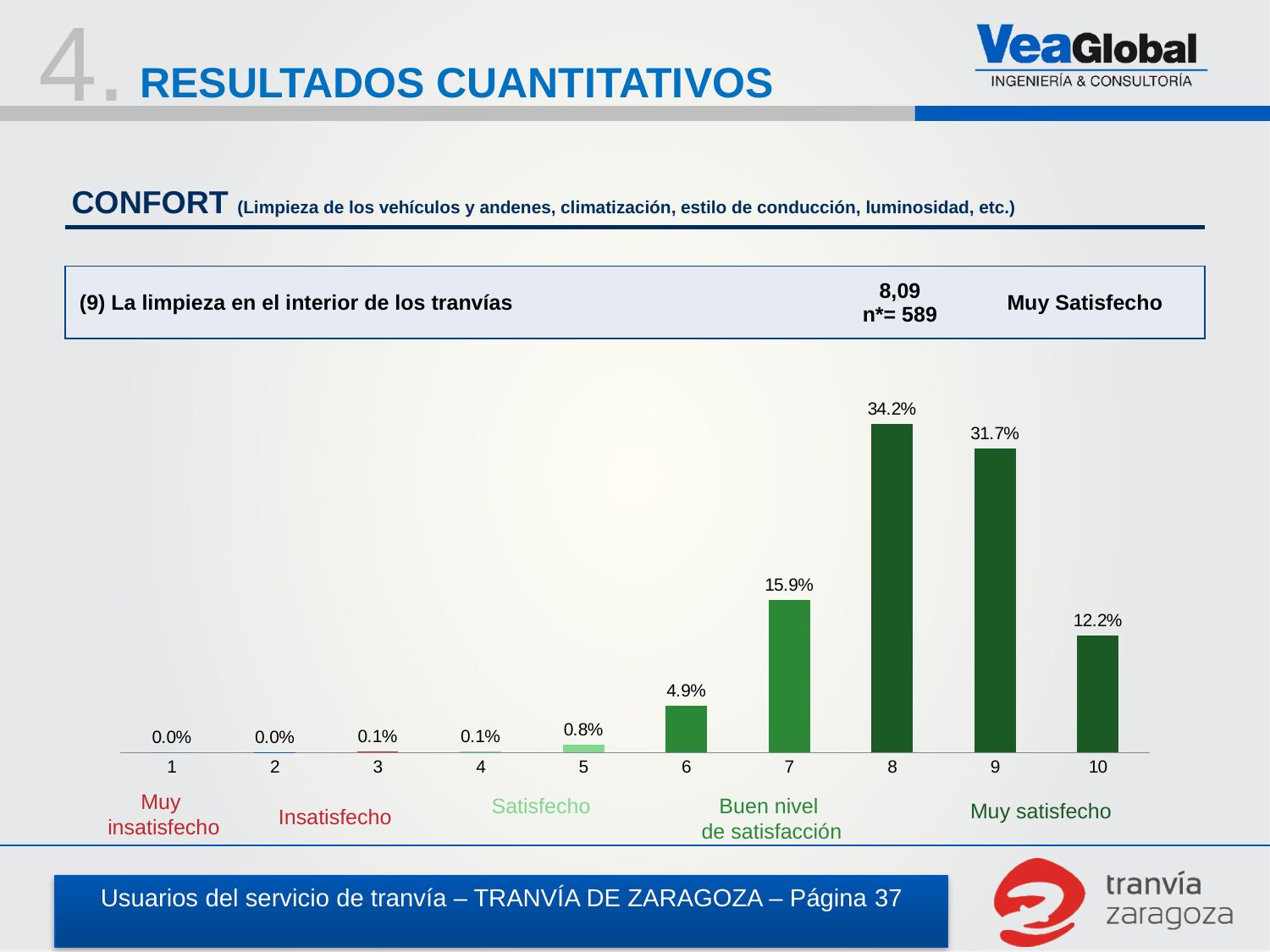
Which score has the highest percentage of respondents? 8 Which has a larger value, score 7 or score 10? 7 What percentage is shown for score 10? 12.2% What is the value shown for score 9? 31.7% What is the difference between the percentages for scores 8 and 9? 2.5% What is the combined percentage for scores 8, 9 and 10? 78.1% What is the difference between the percentages for scores 7 and 6? 11.0% What kind of chart is shown on the slide? bar chart What is the value for score 6? 4.9% What is the average score (media) shown for question (9) La limpieza en el interior de los tranvías? 8,09 How many score categories are shown on the x axis? 10 What percentage of respondents gave a score of 8 for the cleanliness inside the trams? 34.2%